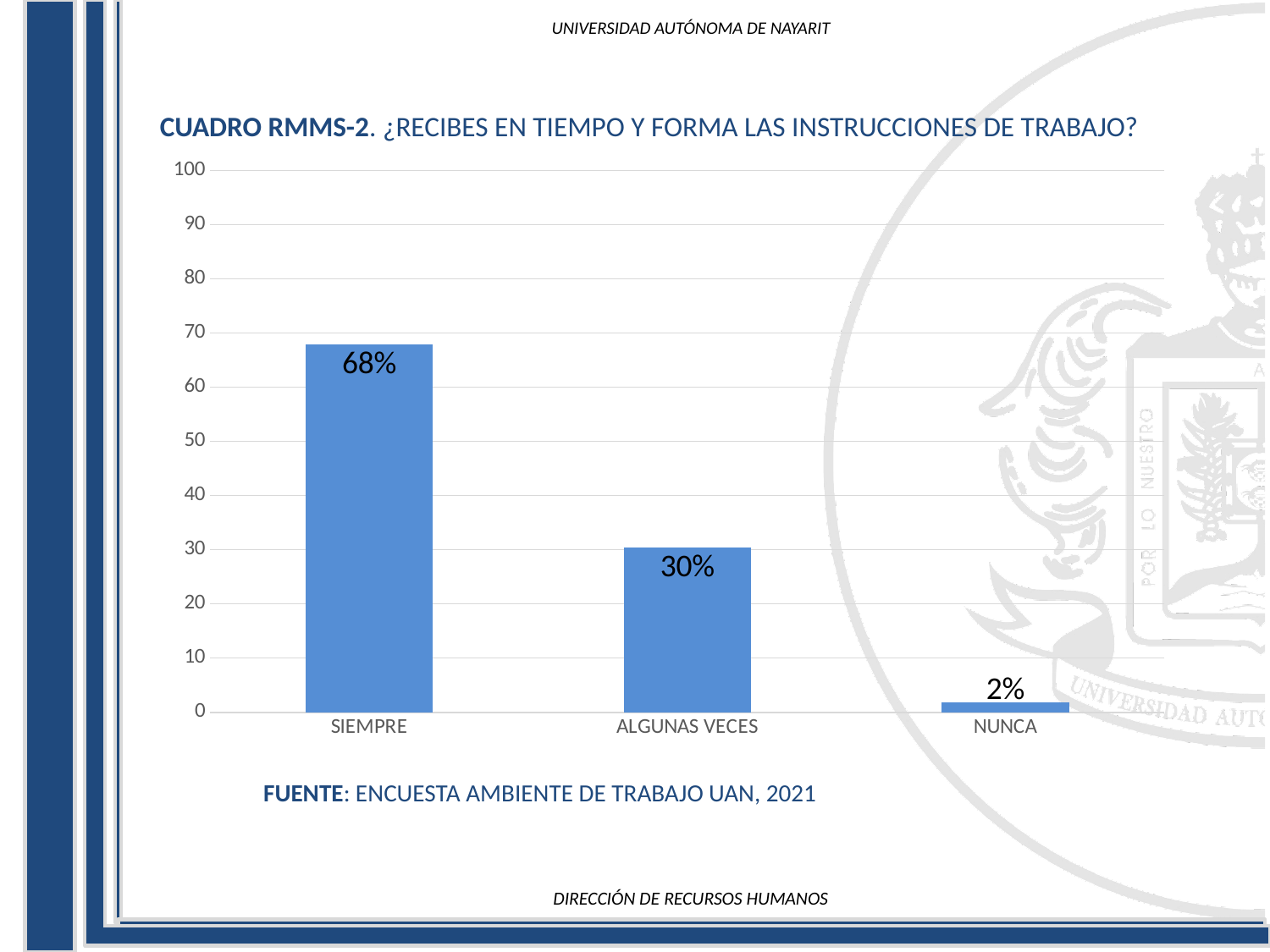
Which is larger, the value for ALGUNAS VECES or the value for NUNCA? ALGUNAS VECES How many categories are shown on the x axis? 3 What is the difference between the values for ALGUNAS VECES and NUNCA? 28% What is the source cited below the chart? ENCUESTA AMBIENTE DE TRABAJO UAN, 2021 What is the value for SIEMPRE? 68% What kind of chart is shown on the slide? bar chart What is the difference between the values for SIEMPRE and ALGUNAS VECES? 38% What is the value for ALGUNAS VECES? 30% Is the value for SIEMPRE greater or less than 60? greater Which category has the lowest value? NUNCA What is the value for NUNCA? 2% Which category has the highest value? SIEMPRE